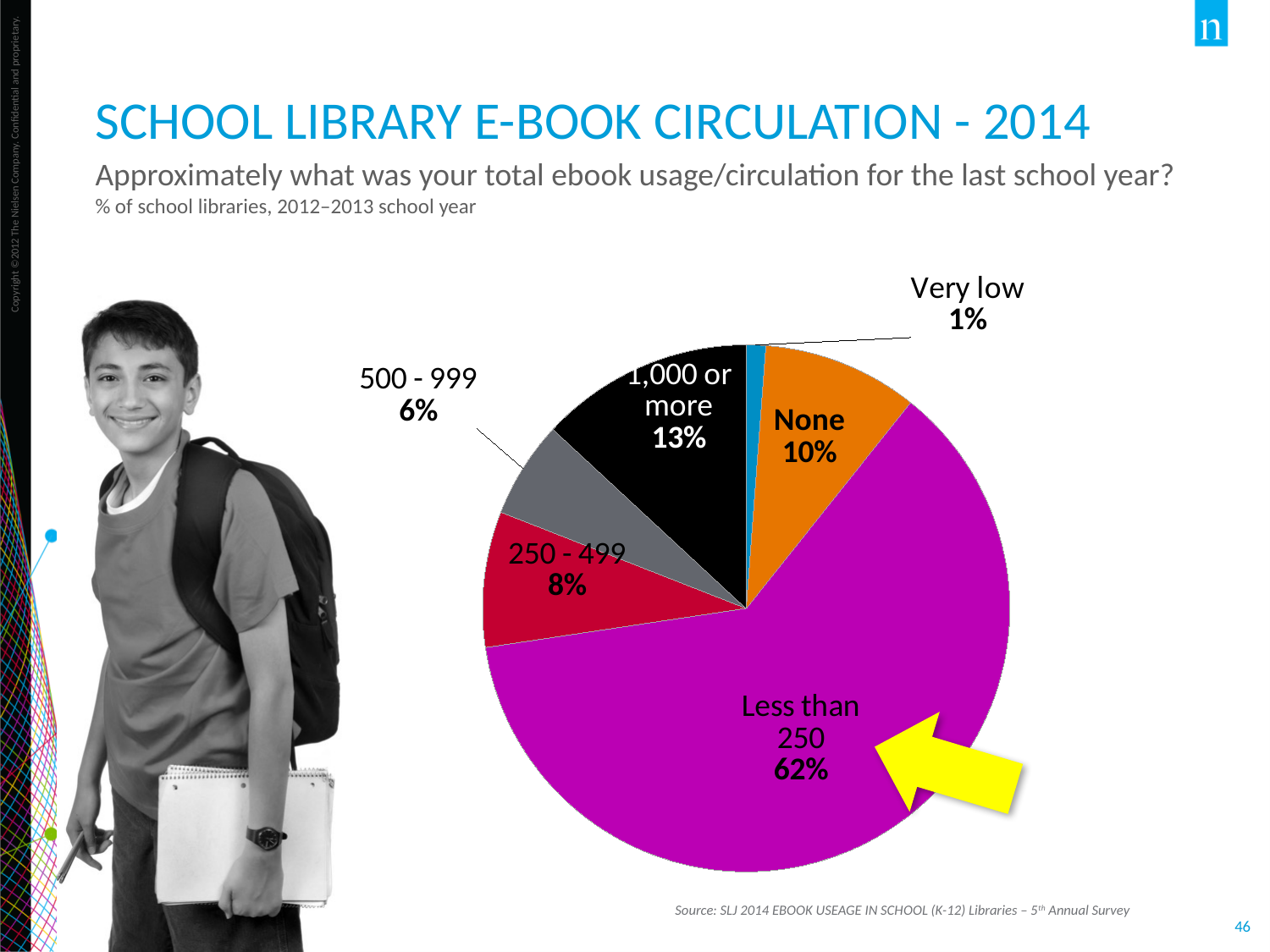
What percentage of school libraries reported ebook circulation of 500 - 999? 6% What percentage of school libraries reported no ebook circulation (None)? 10% What percentage of school libraries reported 1,000 or more ebook circulation? 13% How many slices does the pie chart have? 6 What is the difference in percentage points between the 'Less than 250' slice and the '1,000 or more' slice? 49 Which category has the largest share of the pie? Less than 250 What percentage of school libraries reported ebook circulation of less than 250? 62% What kind of chart is shown on the slide? pie chart Which category has the smallest share of the pie? Very low Which slice does the yellow arrow on the slide point to? Less than 250 What percentage of school libraries reported ebook circulation of 250 - 499? 8% Which is larger, the share for 'None' or the share for '250 - 499'? None